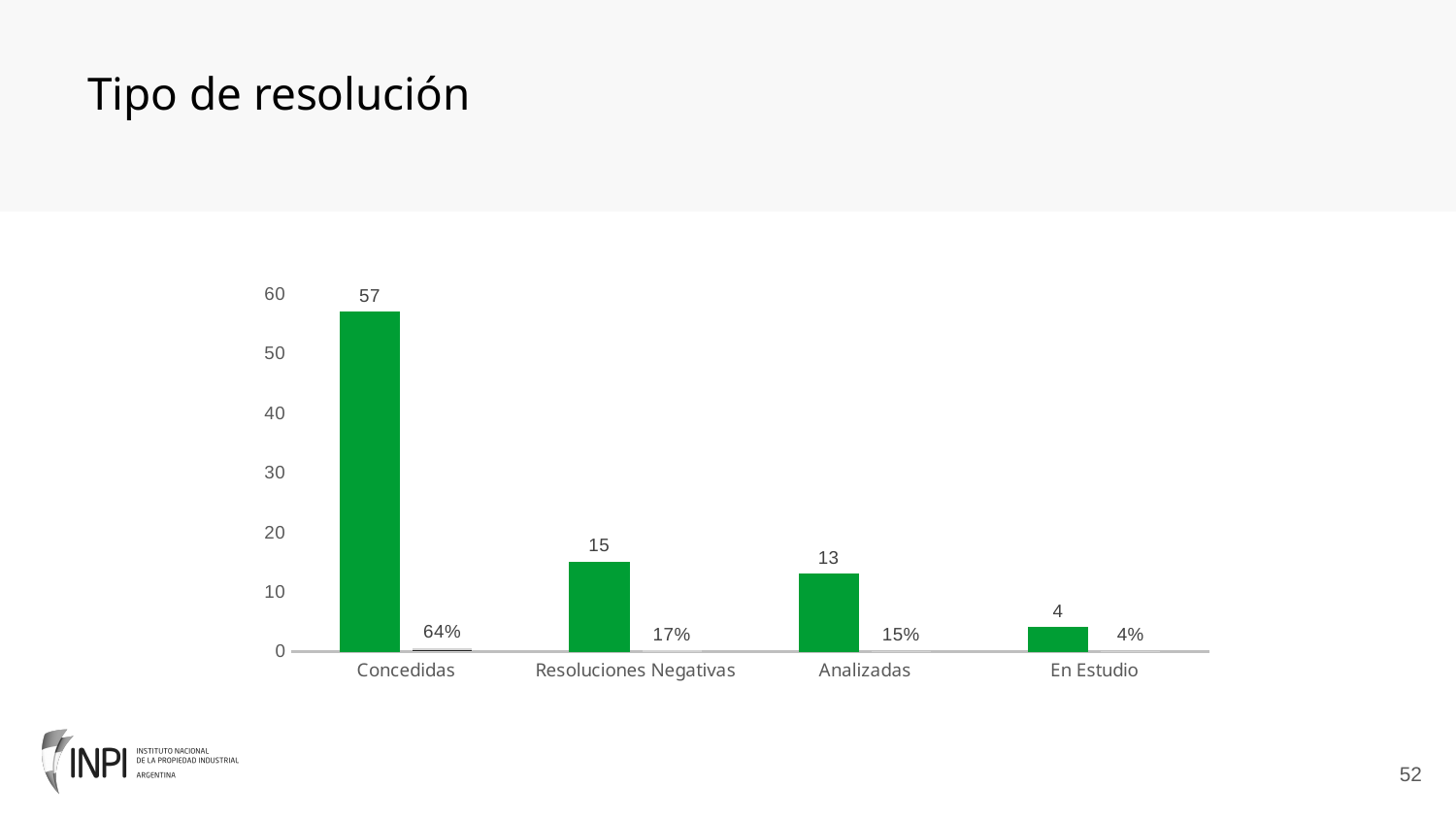
How many categories are shown on the x axis? 4 What kind of chart is shown on the slide? Bar chart Which category has the lowest value? En Estudio What is the value for Analizadas? 13 What is the difference between the values for Concedidas and Resoluciones Negativas? 42 Which category has the highest value? Concedidas Which is larger, the value for Resoluciones Negativas or the value for Analizadas? Resoluciones Negativas What percentage is shown next to Concedidas? 64% What percentage is shown next to En Estudio? 4% What is the value for En Estudio? 4 What is the value for Concedidas? 57 What is the value for Resoluciones Negativas? 15